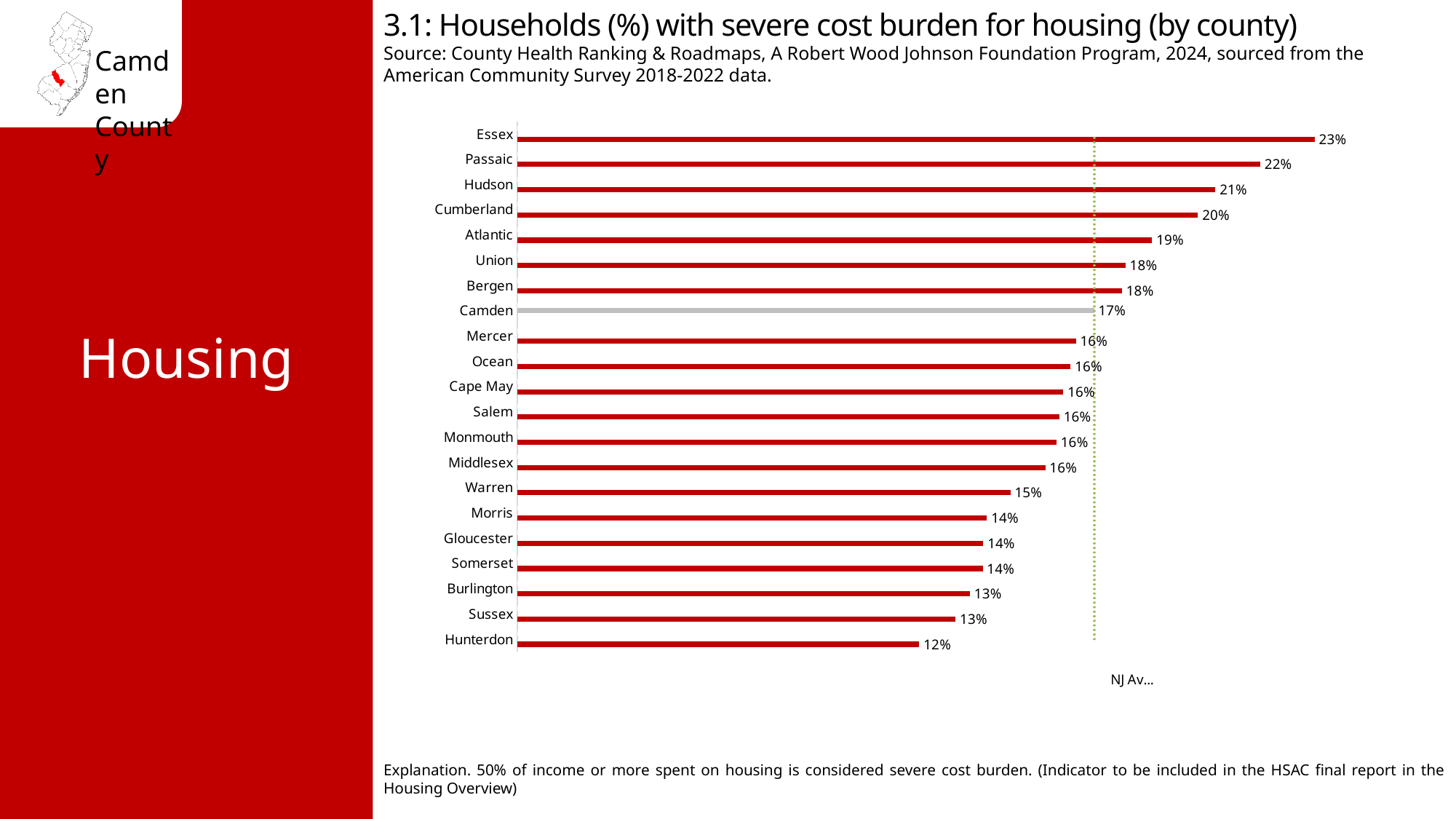
What is the value for Hunterdon? 12% Which county has the lowest value? Hunterdon Which county's bar is shown in grey rather than red? Camden Which county has the highest value? Essex What is the difference between the values for Essex and Hunterdon? 11% What is the value for Atlantic? 19% What is the value for Essex? 23% What is the difference between the values for Passaic and Camden? 5% What is the value for Camden? 17% What kind of chart is this? Bar chart How many counties are shown in the chart? 21 Which is larger, the value for Hudson or the value for Warren? Hudson